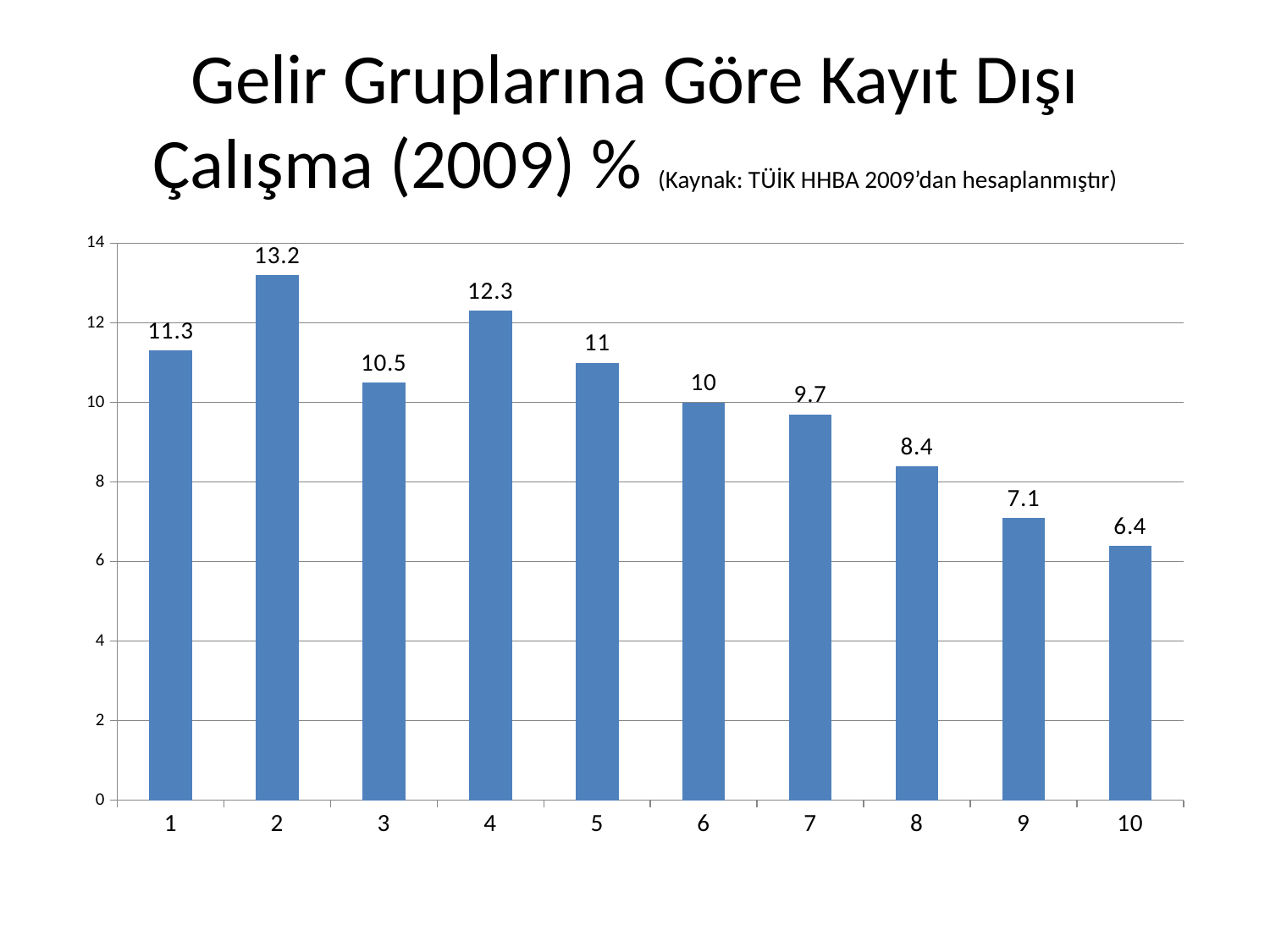
Which is larger, the value for income group 4 or income group 5? income group 4 What is the value for income group 7? 9.7 What kind of chart is shown on the slide? bar chart Is the value for income group 8 greater or less than 10? less What is the difference between the values for income group 2 and income group 10? 6.8 Do the values generally rise or fall from income group 4 to income group 10? fall Which income group has the lowest value? 10 How many income groups are shown on the x axis? 10 What is the value for income group 2? 13.2 What is the difference between the values for income group 1 and income group 3? 0.8 What is the value for income group 10? 6.4 Which income group has the highest value? 2